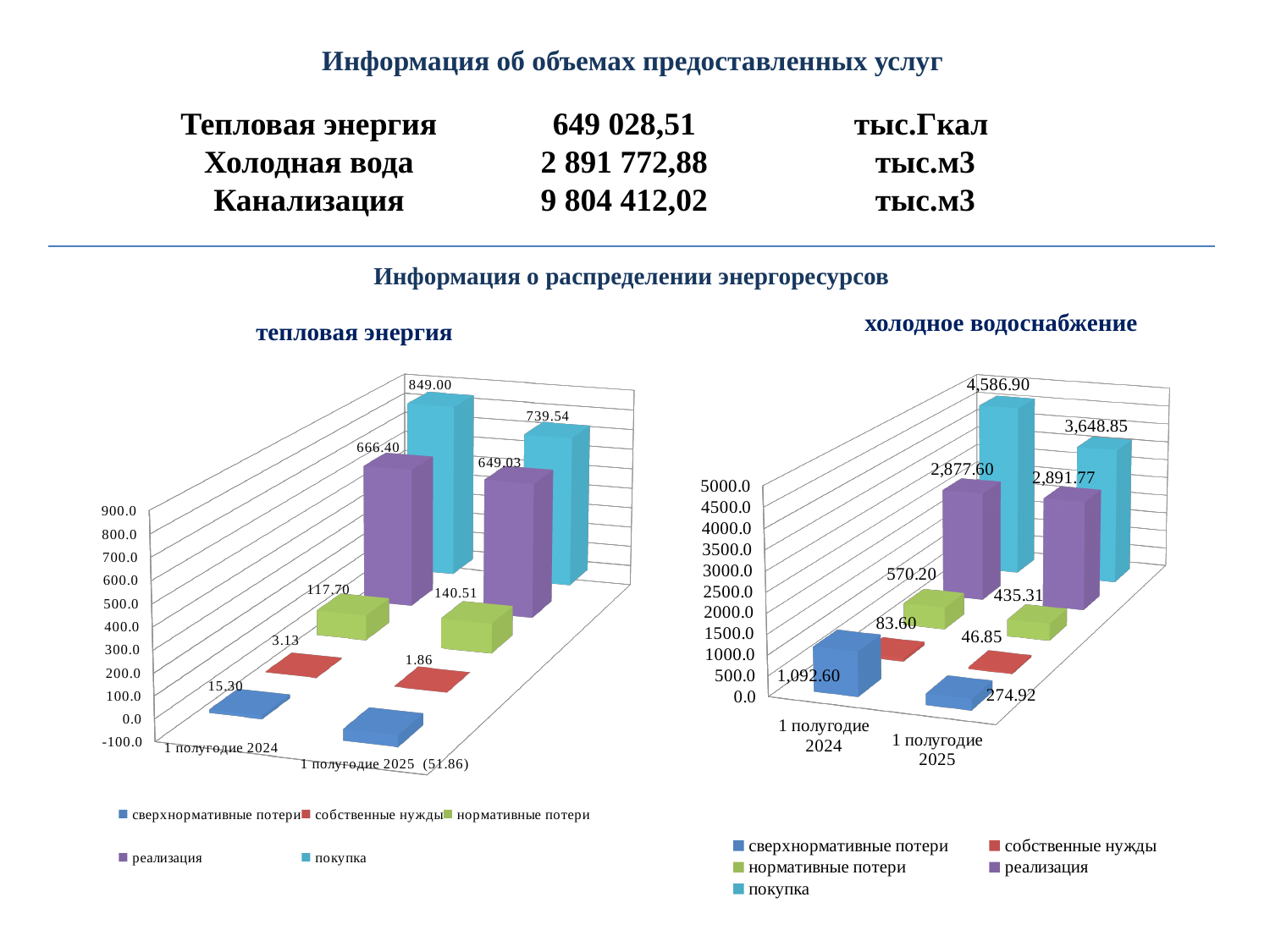
In the 'тепловая энергия' chart, what is the value of 'реализация' for 1 полугодие 2025? 649.03 In the 'холодное водоснабжение' chart, is 'реализация' larger for 1 полугодие 2024 or 1 полугодие 2025? 1 полугодие 2025 In the 'холодное водоснабжение' chart, what is the value of 'сверхнормативные потери' for 1 полугодие 2025? 274.92 In the 'тепловая энергия' chart, which series has the highest value for 1 полугодие 2024? покупка In the 'холодное водоснабжение' chart, what is the difference between 'нормативные потери' for 1 полугодие 2024 and 1 полугодие 2025? 134.89 In the 'тепловая энергия' chart, what is the value of 'покупка' for 1 полугодие 2024? 849.00 In the 'тепловая энергия' chart, what is the difference between 'покупка' for 1 полугодие 2024 and 1 полугодие 2025? 109.46 What type of chart is the 'холодное водоснабжение' chart? bar chart In the 'холодное водоснабжение' chart, what is the value of 'покупка' for 1 полугодие 2024? 4,586.90 In the 'холодное водоснабжение' chart, which series has the lowest value for 1 полугодие 2025? собственные нужды In the 'тепловая энергия' chart, what is the value of 'нормативные потери' for 1 полугодие 2025? 140.51 In the 'тепловая энергия' chart, how many series does the legend list? 5